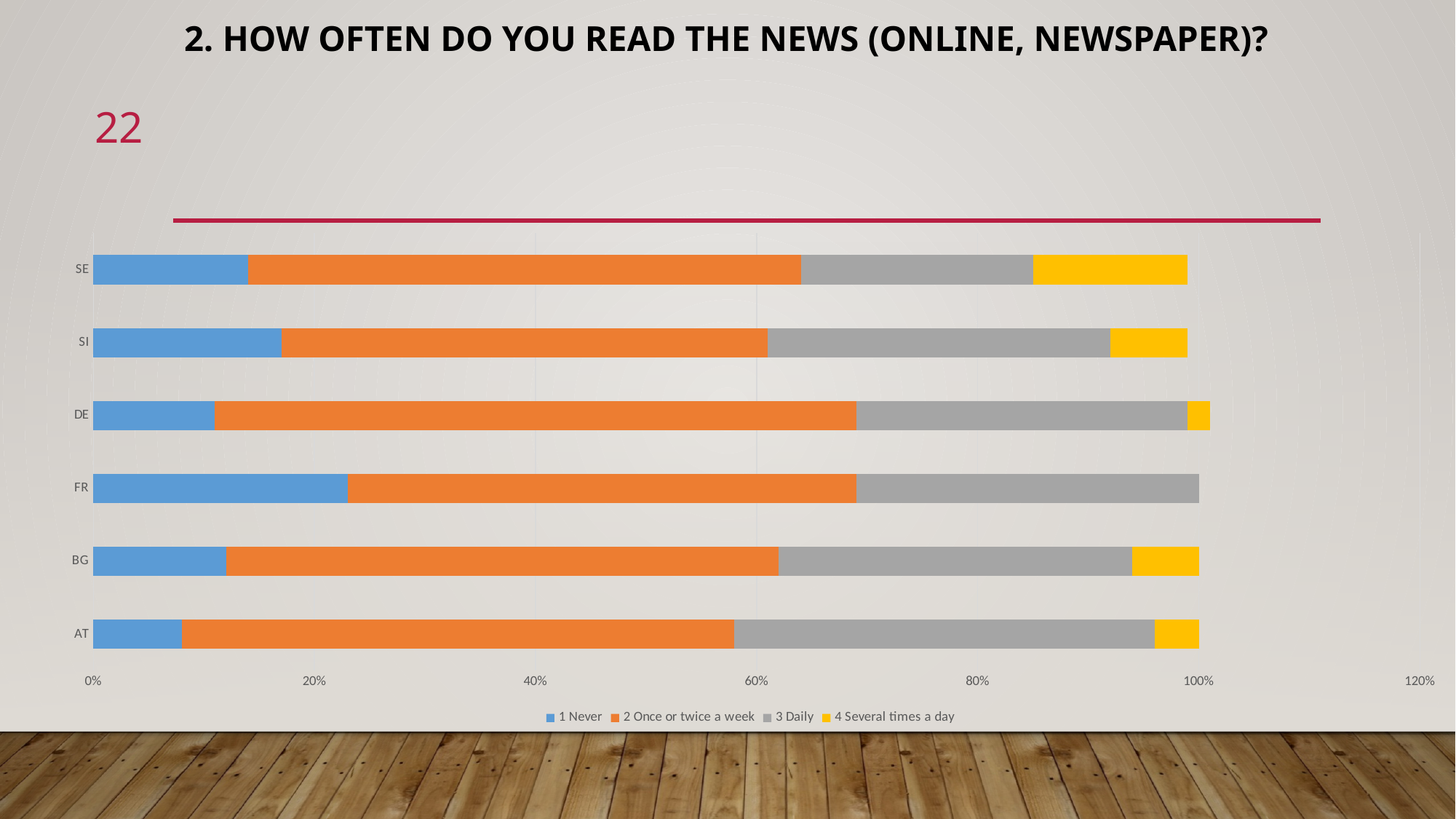
Which series is shown in orange in the legend? 2 Once or twice a week Which country has the largest share for '1 Never'? FR How many series does the legend list? 4 Which is larger, the '1 Never' share for FR or for AT? FR Which is larger, the '4 Several times a day' share for SE or for DE? SE Which country has the largest share for '4 Several times a day'? SE What is the title of the slide? 2. How often do you read the news (online, newspaper)? Which country has the smallest share for '1 Never'? AT What kind of chart is shown on the slide? Stacked bar chart Is the '1 Never' share for AT greater or less than 20%? less How many countries are shown on the chart? 6 Is the '1 Never' share for FR greater or less than 20%? greater